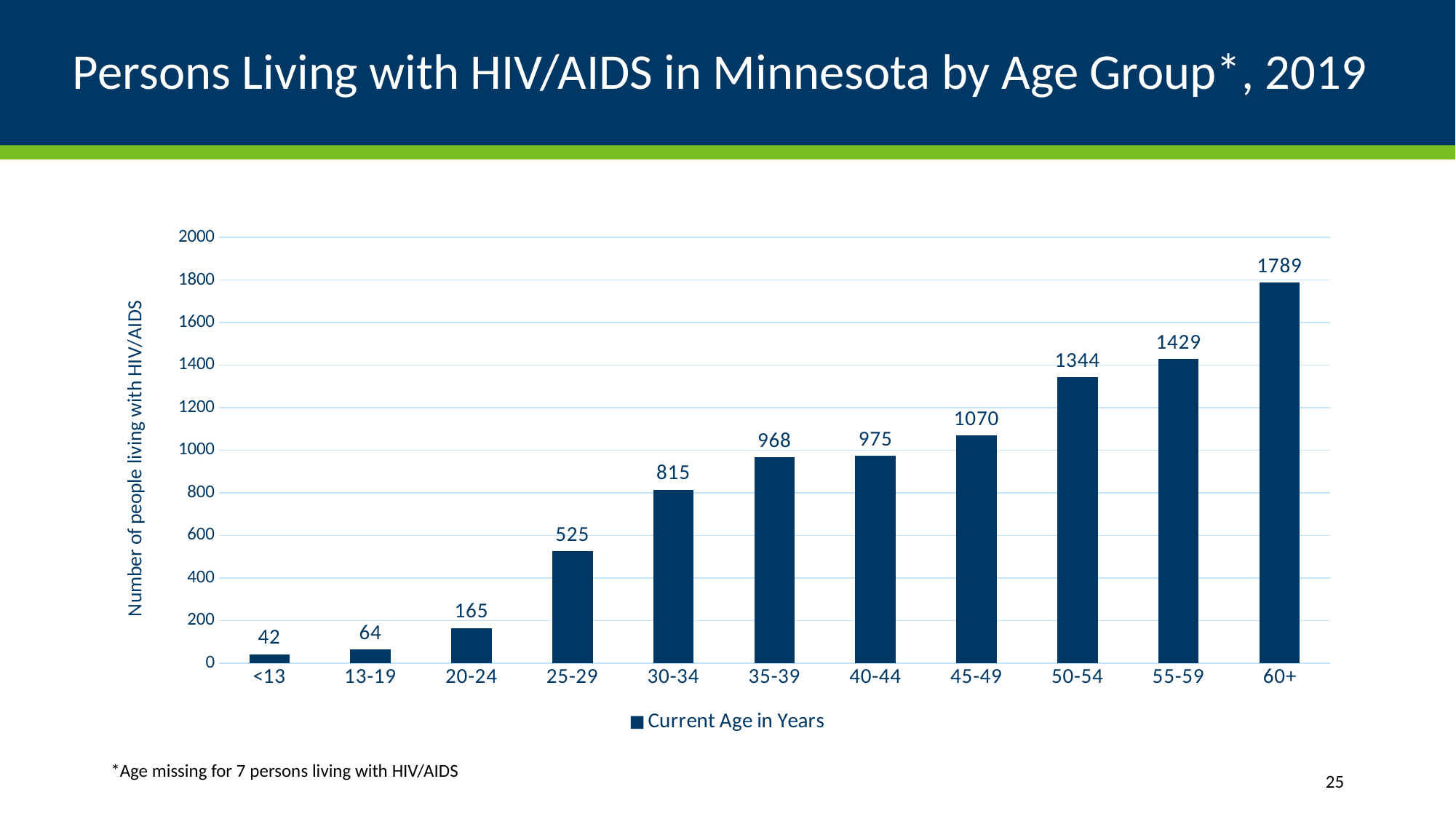
Which age group has the lowest number of persons living with HIV/AIDS? <13 Which age group has a larger value, 25-29 or 45-49? 45-49 What kind of chart is shown on the slide? bar chart What is the value shown for the 60+ age group? 1789 How many series does the legend list? 1 What is the difference between the values for the 55-59 and 50-54 age groups? 85 Which age group has the highest number of persons living with HIV/AIDS? 60+ Is the value for the 35-39 age group greater or less than 1000? less What is the value shown for the <13 age group? 42 How many persons living with HIV/AIDS are in the 30-34 age group? 815 How many age groups are shown on the x axis? 11 Do the values generally rise or fall from the <13 age group to the 60+ age group? rise